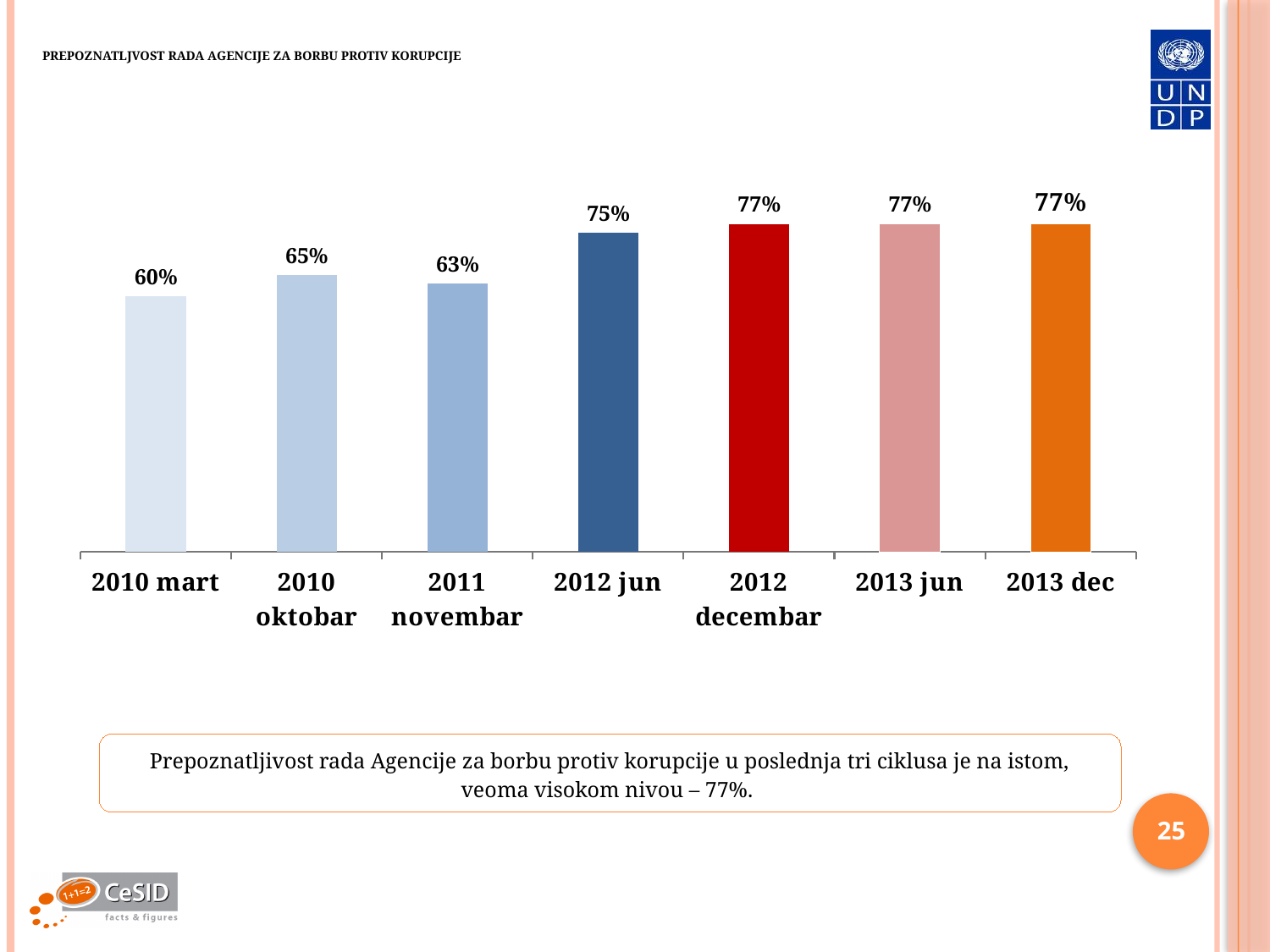
Which category has the lowest value? 2010 mart What kind of chart is shown on the slide? bar chart What colour is the bar for 2012 decembar? red What is the value for 2010 mart? 60% How many categories are shown on the x axis? 7 Do the values generally rise or fall from 2011 novembar to 2013 dec? rise What is the value for 2013 dec? 77% What is the value for 2011 novembar? 63% What is the difference between the values for 2010 oktobar and 2011 novembar? 2% Which is larger, the value for 2010 oktobar or the value for 2011 novembar? 2010 oktobar What is the value for 2012 jun? 75% What is the difference between the values for 2012 jun and 2010 mart? 15%